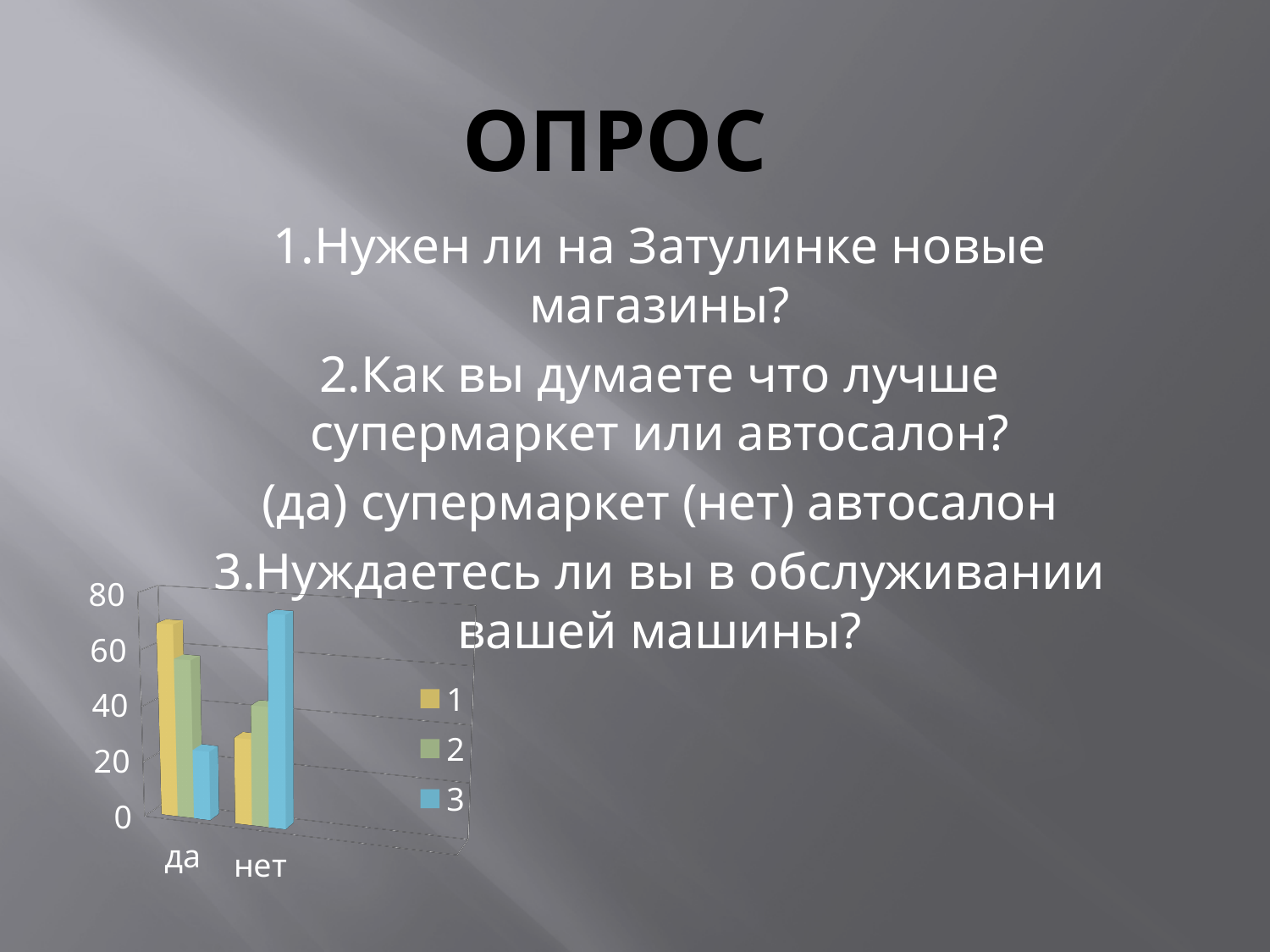
How many series does the chart legend list? 3 Is the value for series 1 in the "нет" category greater or less than 40? less Is the value for series 3 in the "да" category greater or less than 40? less Is the value for series 3 in the "нет" category greater or less than 60? greater Which series has the lowest value in the "да" category? 3 What are the entries in the chart legend? 1, 2, 3 What are the category labels on the x axis of the chart? да, нет In the "нет" category, which is larger: the value for series 1 or series 3? 3 What kind of chart is shown on the slide? bar chart Which series has the highest value in the "да" category? 1 How many categories are shown on the x axis of the chart? 2